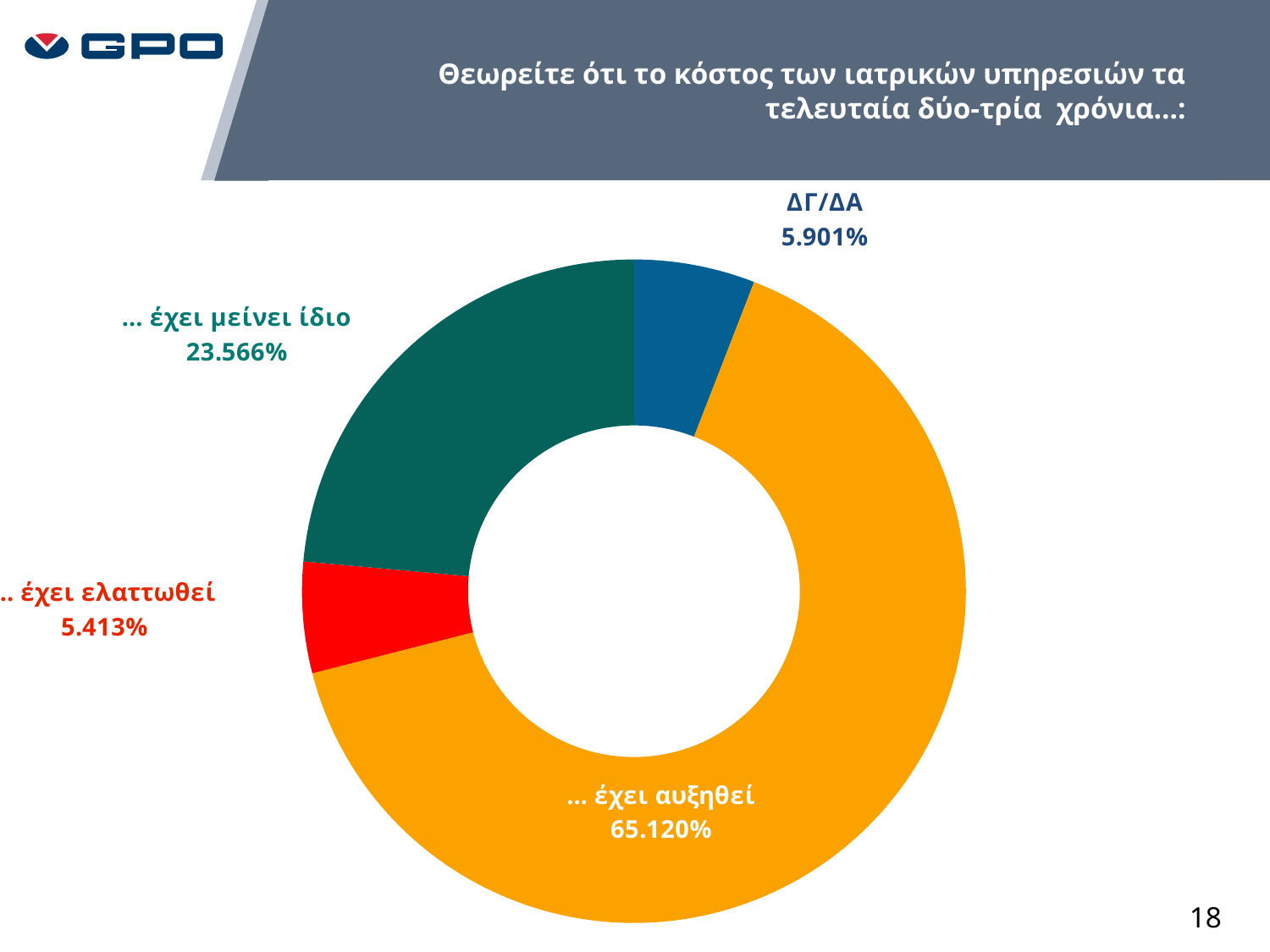
Which category has the largest share of the chart? ... έχει αυξηθεί Which is larger, the share for "ΔΓ/ΔΑ" or the share for "... έχει ελαττωθεί"? ΔΓ/ΔΑ What percentage is shown for "... έχει μείνει ίδιο"? 23.566% What colour is the slice for "... έχει αυξηθεί"? Orange What is the difference in percentage points between "... έχει αυξηθεί" and "... έχει μείνει ίδιο"? 41.554% Which category has the smallest share of the chart? ... έχει ελαττωθεί What percentage is shown for "ΔΓ/ΔΑ"? 5.901% What percentage is shown for "... έχει αυξηθεί"? 65.120% What kind of chart is shown on the slide? Doughnut (pie) chart What percentage is shown for "... έχει ελαττωθεί"? 5.413% How many categories (slices) does the chart have? 4 What share of the chart does the "... έχει μείνει ίδιο" slice represent? 23.566%